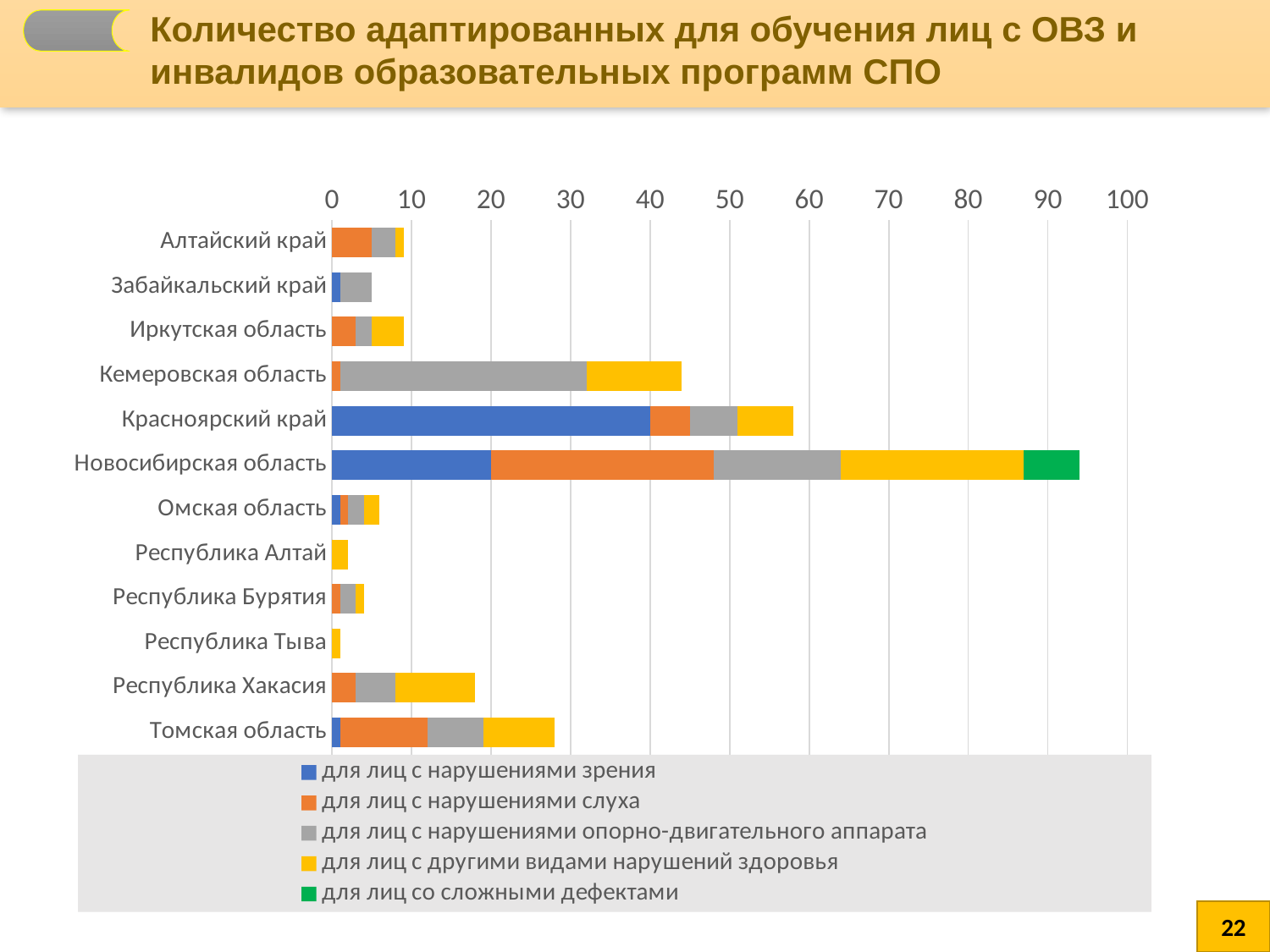
How many regions (categories) are shown on the chart? 12 How many series does the legend list? 5 What kind of chart is shown on the slide? Stacked bar chart Which has the larger total: Красноярский край or Кемеровская область? Красноярский край Which region has the lowest total number of adapted programmes? Республика Тыва Is the total value for Красноярский край greater or less than 50? greater Which region is the only one with a segment for 'для лиц со сложными дефектами'? Новосибирская область Is the total value for Новосибирская область greater or less than 80? greater Which region has the highest total number of adapted programmes? Новосибирская область Is the total value for Томская область greater or less than 30? less Which colour represents 'для лиц с нарушениями слуха' in the legend? Orange